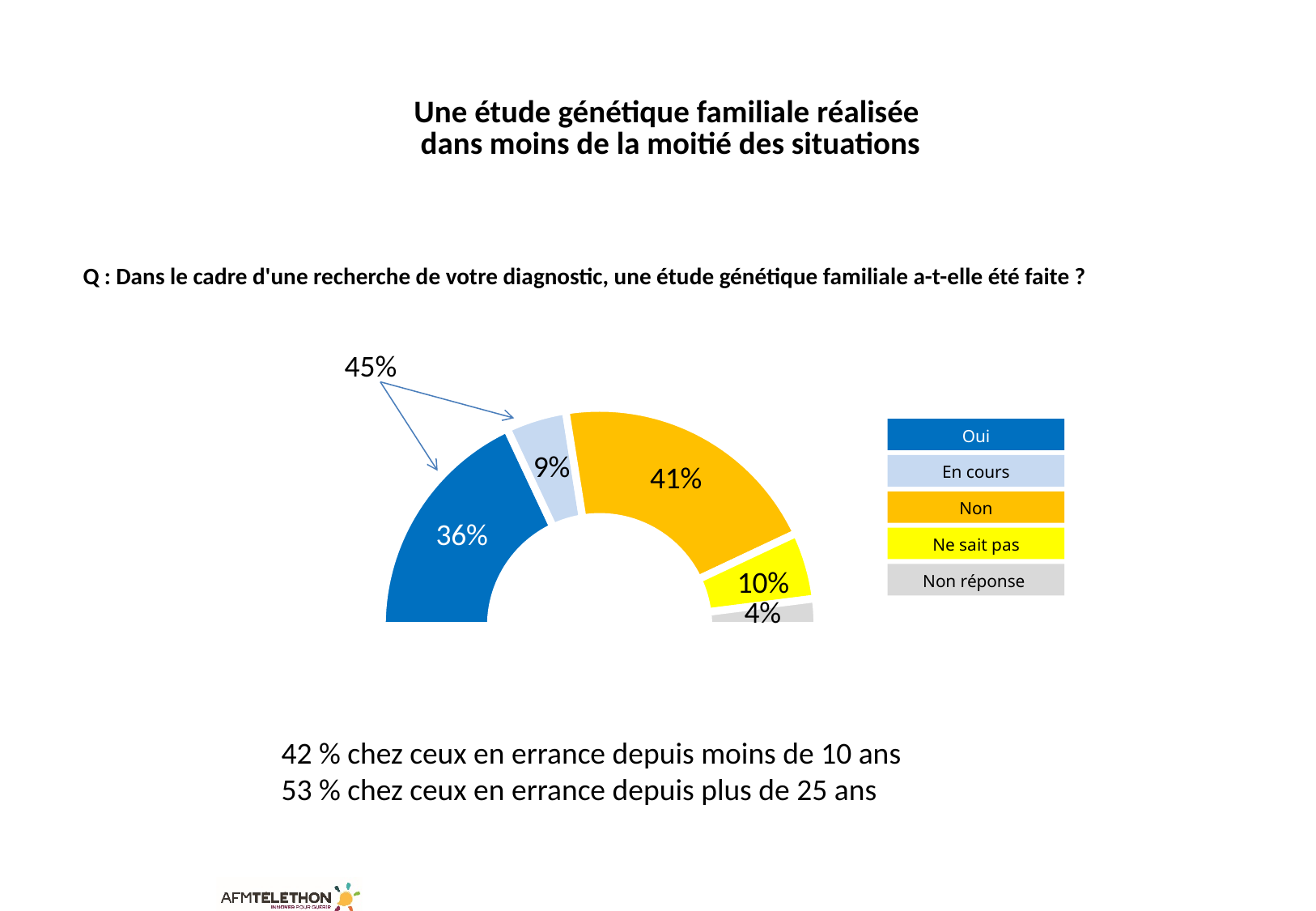
What combined percentage is indicated by the arrows pointing to the "Oui" and "En cours" segments? 45% What percentage of respondents answered "Oui"? 36% Which category has the smallest share? Non réponse Which category has the largest share? Non What percentage of respondents answered "Non"? 41% Which is larger, the share for "Oui" or the share for "Non"? Non How many categories does the legend list? 5 What percentage is shown for "Ne sait pas"? 10% What percentage is shown for "En cours"? 9% What percentage is shown for "Non réponse"? 4% What is the difference in percentage points between "Non" and "Oui"? 5 What colour is the "Ne sait pas" segment? Yellow